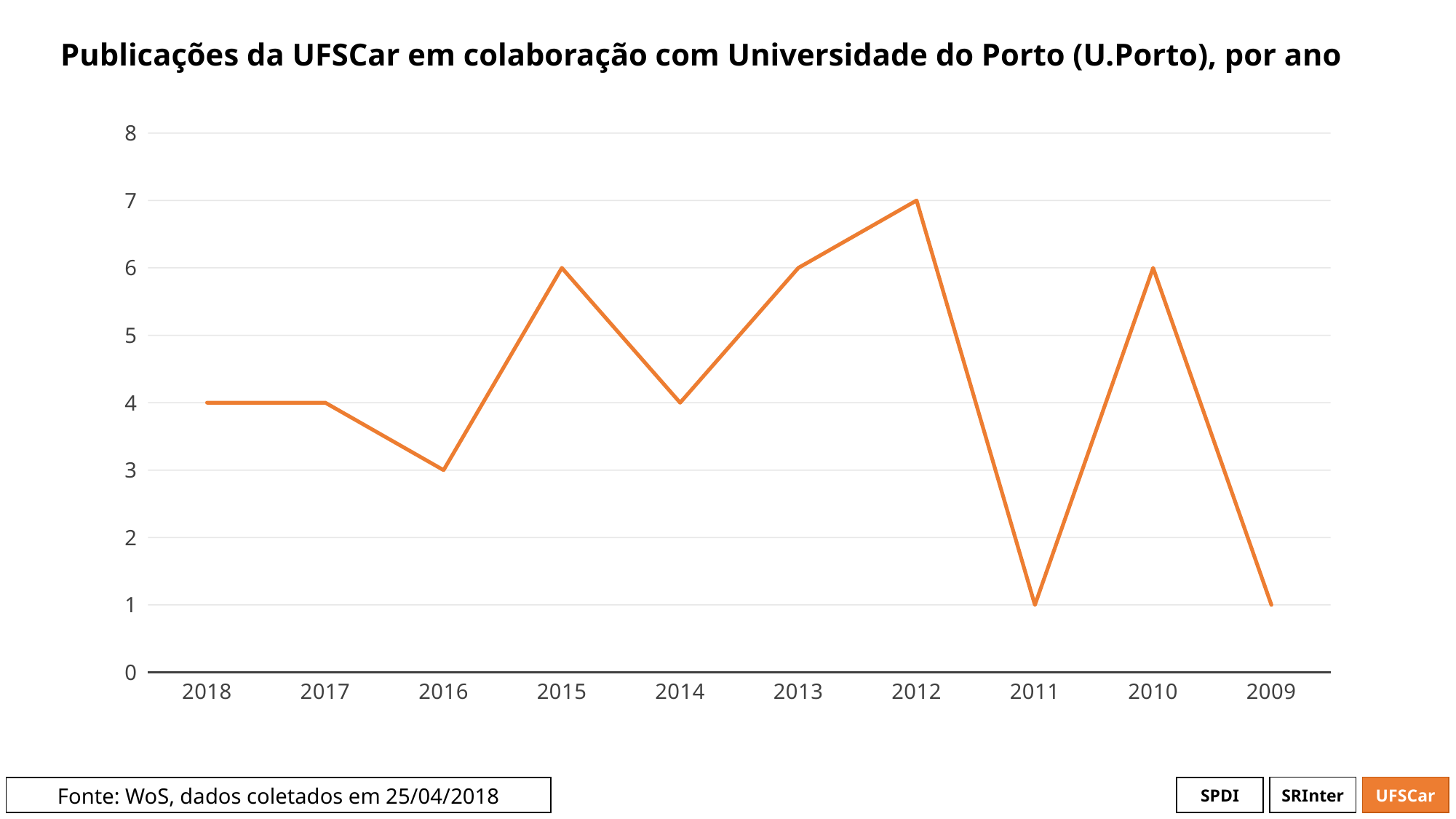
What type of chart is shown on the slide? line chart What is the difference between the values for 2012 and 2011? 6 What is the value for 2012? 7 Is the value for 2009 greater or less than 2? less What is the value for 2016? 3 Is the value for 2010 greater or less than 5? greater What is the title of the chart? Publicações da UFSCar em colaboração com Universidade do Porto (U.Porto), por ano How many years are plotted on the x axis? 10 Which value is larger, 2015 or 2014? 2015 Which year has the highest value? 2012 What is the value for 2011? 1 What is the source stated at the bottom of the slide? WoS, dados coletados em 25/04/2018